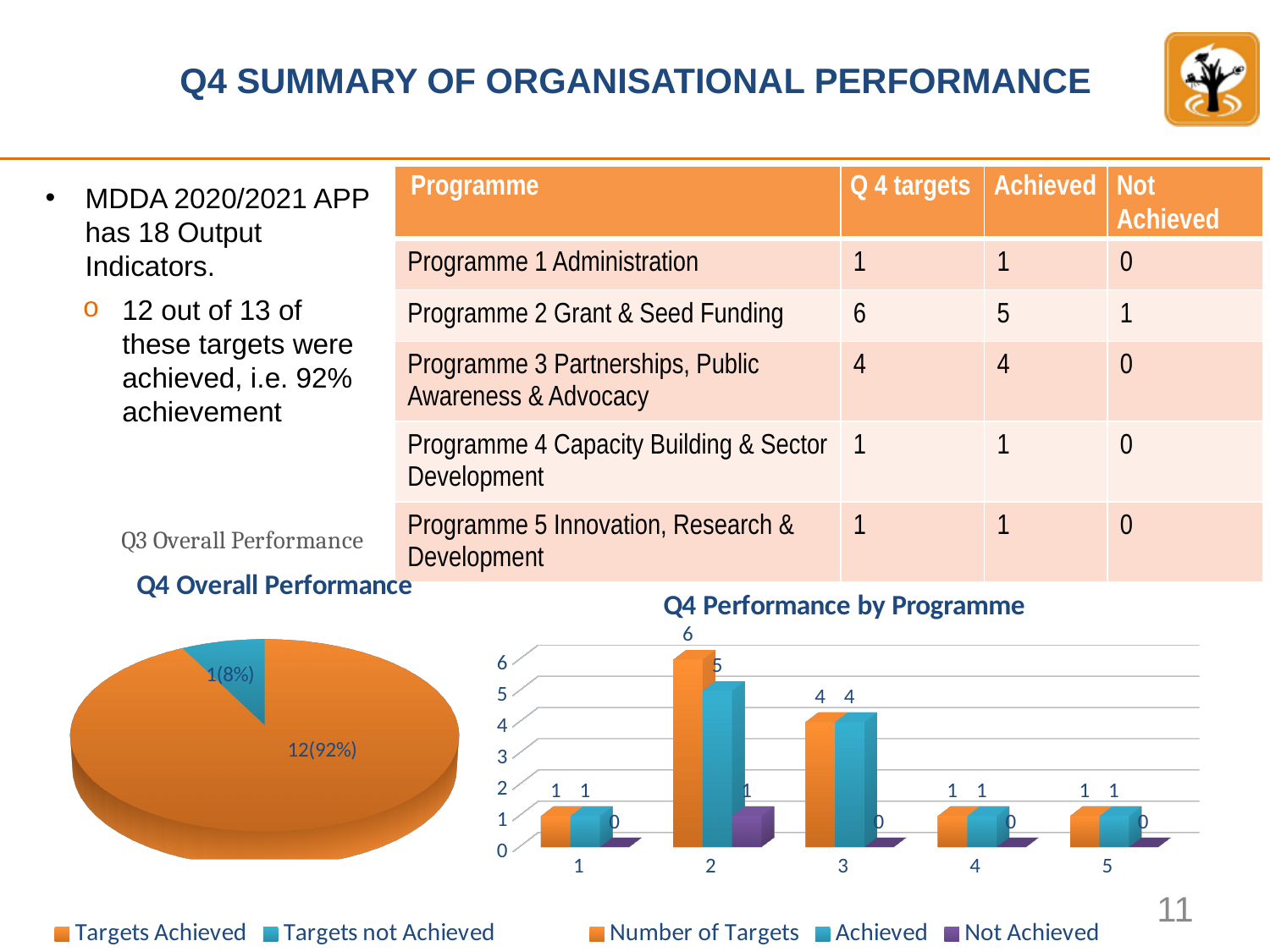
In the Q4 Performance by Programme chart, what is the Number of Targets value for programme 2? 6 In the Q4 Performance by Programme chart, which programme has the highest Number of Targets? 2 In the Q4 Performance by Programme chart, what is the difference between Number of Targets and Achieved for programme 2? 1 In the Q4 Performance by Programme chart, what is the Achieved value for programme 3? 4 In the Q4 Performance by Programme chart, which is larger for programme 2: Achieved or Not Achieved? Achieved What kind of chart is the Q4 Performance by Programme chart? Bar chart What kind of chart is the Q4 Overall Performance chart? Pie chart How many programme categories are shown on the x axis of the Q4 Performance by Programme chart? 5 How many series does the legend of the Q4 Overall Performance chart list? 2 In the Q4 Overall Performance chart, what share of the pie is Targets not Achieved? 8% How many series does the legend of the Q4 Performance by Programme chart list? 3 In the Q4 Overall Performance chart, what is the label shown for the Targets Achieved slice? 12(92%)